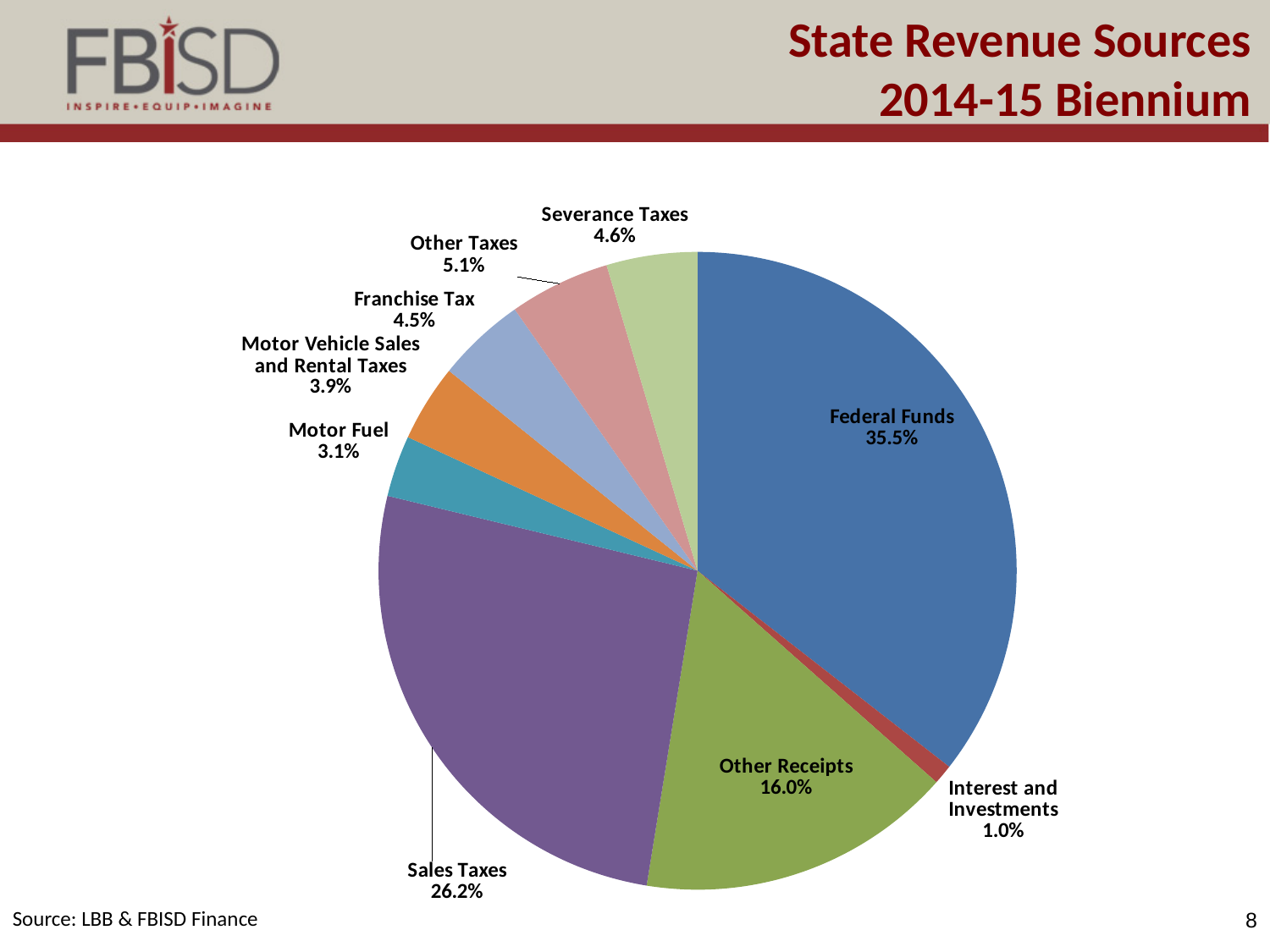
What is the difference in percentage points between Other Receipts and Motor Fuel? 12.9 What type of chart is shown on the slide? Pie chart What percentage is shown for Motor Vehicle Sales and Rental Taxes? 3.9% Which revenue source has the smallest share of the pie? Interest and Investments How many revenue sources are shown in the pie chart? 9 What percentage of state revenue is from Sales Taxes? 26.2% What is the share for Interest and Investments? 1.0% What share of state revenue comes from Federal Funds? 35.5% What is the title of the slide containing the pie chart? State Revenue Sources 2014-15 Biennium Which revenue source has the largest share of the pie? Federal Funds Which is larger, the share for Other Taxes or the share for Severance Taxes? Other Taxes What is the difference in percentage points between Federal Funds and Sales Taxes? 9.3